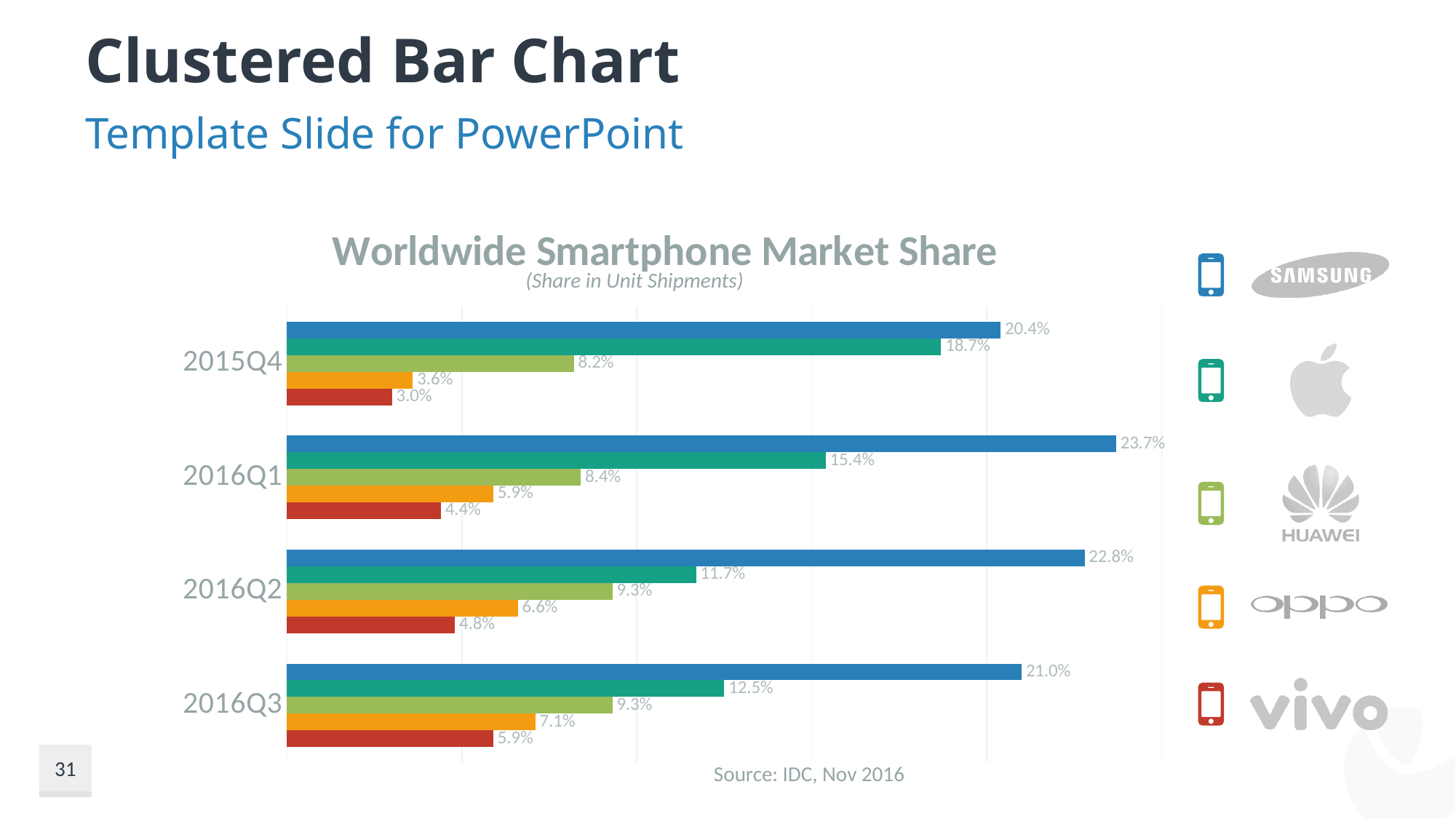
Which is larger in 2016Q3: Huawei's share or OPPO's share? Huawei's share What is the difference between Samsung's and Apple's market share in 2016Q2? 11.1% How many quarters are shown on the chart? 4 Which brand has the lowest market share in 2015Q4? vivo In which quarter does Samsung have its highest market share? 2016Q1 What is OPPO's market share in 2016Q2? 6.6% How many brands (series) does the chart show? 5 What is the title of the chart? Worldwide Smartphone Market Share What is Samsung's market share in 2016Q1? 23.7% What type of chart is shown on the slide? Bar chart What is Apple's market share in 2015Q4? 18.7% What is vivo's market share in 2016Q3? 5.9%